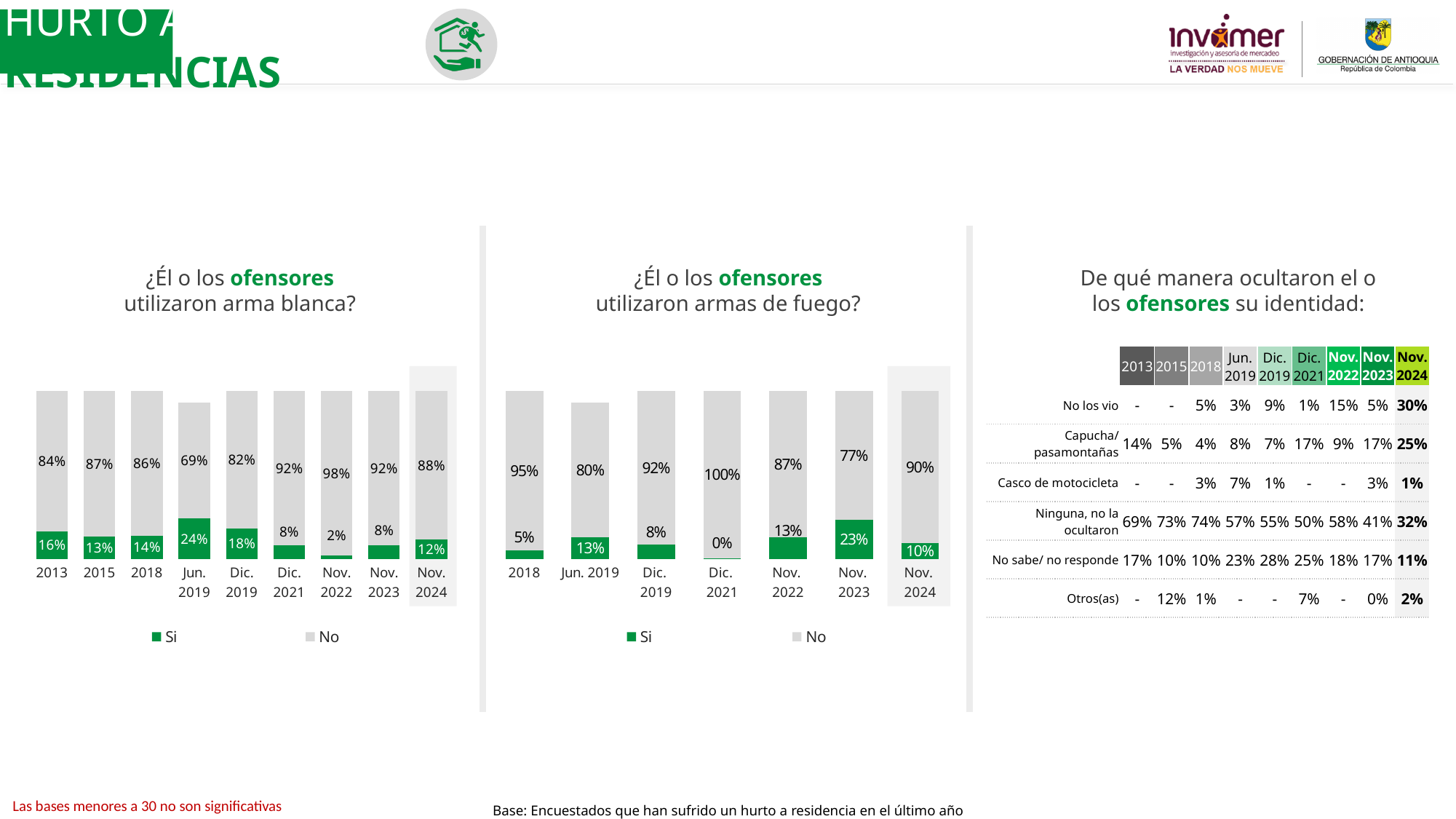
In the chart '¿Él o los ofensores utilizaron armas de fuego?', which is larger: the 'Si' value for Jun. 2019 or the 'Si' value for Dic. 2019? Jun. 2019 In the chart '¿Él o los ofensores utilizaron armas de fuego?', what is the 'Si' value for Nov. 2023? 23% What type of chart is '¿Él o los ofensores utilizaron arma blanca?'? Stacked bar chart In the chart '¿Él o los ofensores utilizaron arma blanca?', what is the 'Si' value for Jun. 2019? 24% In the chart '¿Él o los ofensores utilizaron armas de fuego?', which period has the highest 'No' value? Dic. 2021 In the chart '¿Él o los ofensores utilizaron armas de fuego?', how many periods are shown on the x axis? 7 In the chart '¿Él o los ofensores utilizaron arma blanca?', what is the 'No' value for Nov. 2022? 98% In the chart '¿Él o los ofensores utilizaron arma blanca?', how many periods are shown on the x axis? 9 In the chart '¿Él o los ofensores utilizaron arma blanca?', what is the difference between the 'Si' values for 2013 and Nov. 2024? 4% In the chart '¿Él o los ofensores utilizaron arma blanca?', which period has the highest 'Si' value? Jun. 2019 In the chart '¿Él o los ofensores utilizaron arma blanca?', which period has the lowest 'Si' value? Nov. 2022 In the chart '¿Él o los ofensores utilizaron armas de fuego?', how many series does the legend list? 2